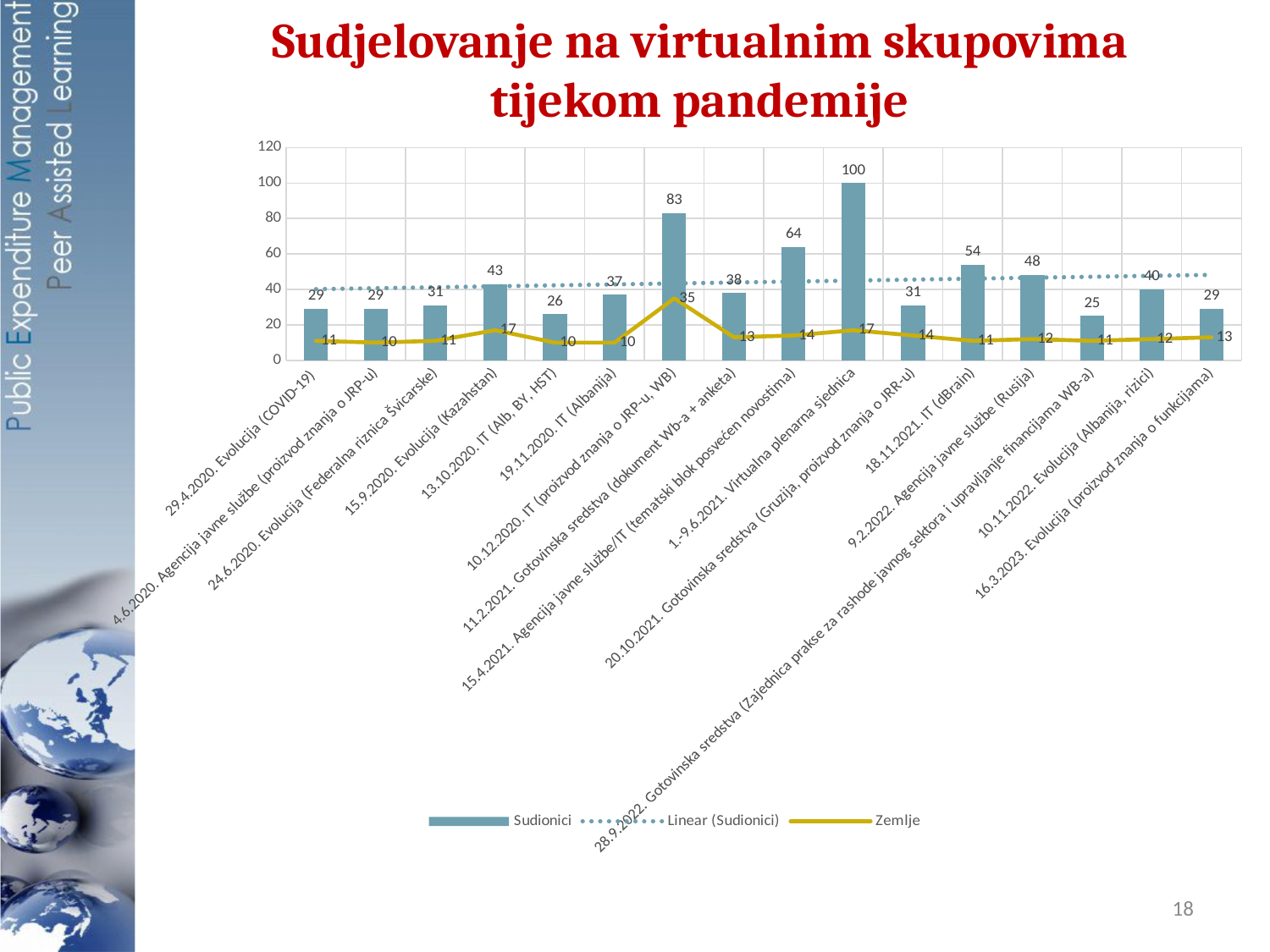
Does the Linear (Sudionici) trend line rise or fall along the x axis? Rise Which category has the lowest Sudionici value? 28.9.2022. Gotovinska sredstva (Zajednica prakse za rashode javnog sektora i upravljanje financijama WB-a) What is the Sudionici value for 18.11.2021. IT (dBrain)? 54 Which category has the highest Sudionici value? 1.-9.6.2021. Virtualna plenarna sjednica What is the difference between the Sudionici values for 10.12.2020. IT (proizvod znanja o JRP-u, WB) and 15.4.2021. Agencija javne službe/IT (tematski blok posvećen novostima)? 19 What is the title of the chart? Sudjelovanje na virtualnim skupovima tijekom pandemije What is the Sudionici value for 1.-9.6.2021. Virtualna plenarna sjednica? 100 How many series does the legend list? 3 How many categories are shown on the x axis? 16 What is the Zemlje value for 10.12.2020. IT (proizvod znanja o JRP-u, WB)? 35 Which has a higher Sudionici value: 15.9.2020. Evolucija (Kazahstan) or 9.2.2022. Agencija javne službe (Rusija)? 9.2.2022. Agencija javne službe (Rusija) What kind of chart is used for the Sudionici series? Bar chart